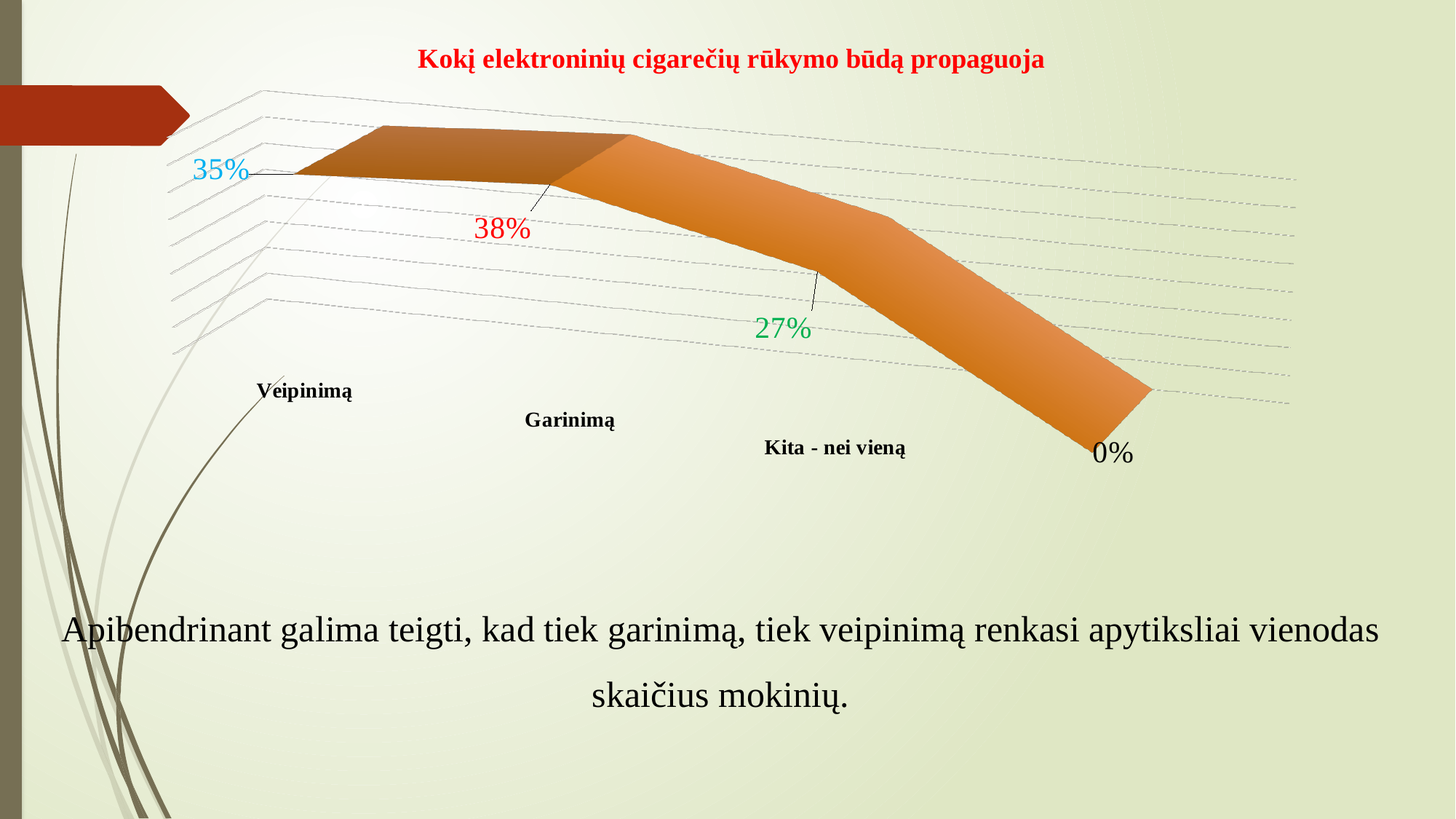
Which is larger, the value for Garinimą or the value for Kita - nei vieną? Garinimą What is the value for Garinimą? 38% What is the value for Kita - nei vieną? 27% What is the difference between the values for Garinimą and Veipinimą? 3% Do the values rise or fall from Garinimą to the last point on the chart? fall How many data labels are shown on the chart? 4 What is the difference between the values for Veipinimą and Kita - nei vieną? 8% What is the title of the chart? Kokį elektroninių cigarečių rūkymo būdą propaguoja What is the value for Veipinimą? 35% Which labelled category has the lowest value? Kita - nei vieną What kind of chart is shown on the slide? 3D line chart Which labelled category has the highest value? Garinimą